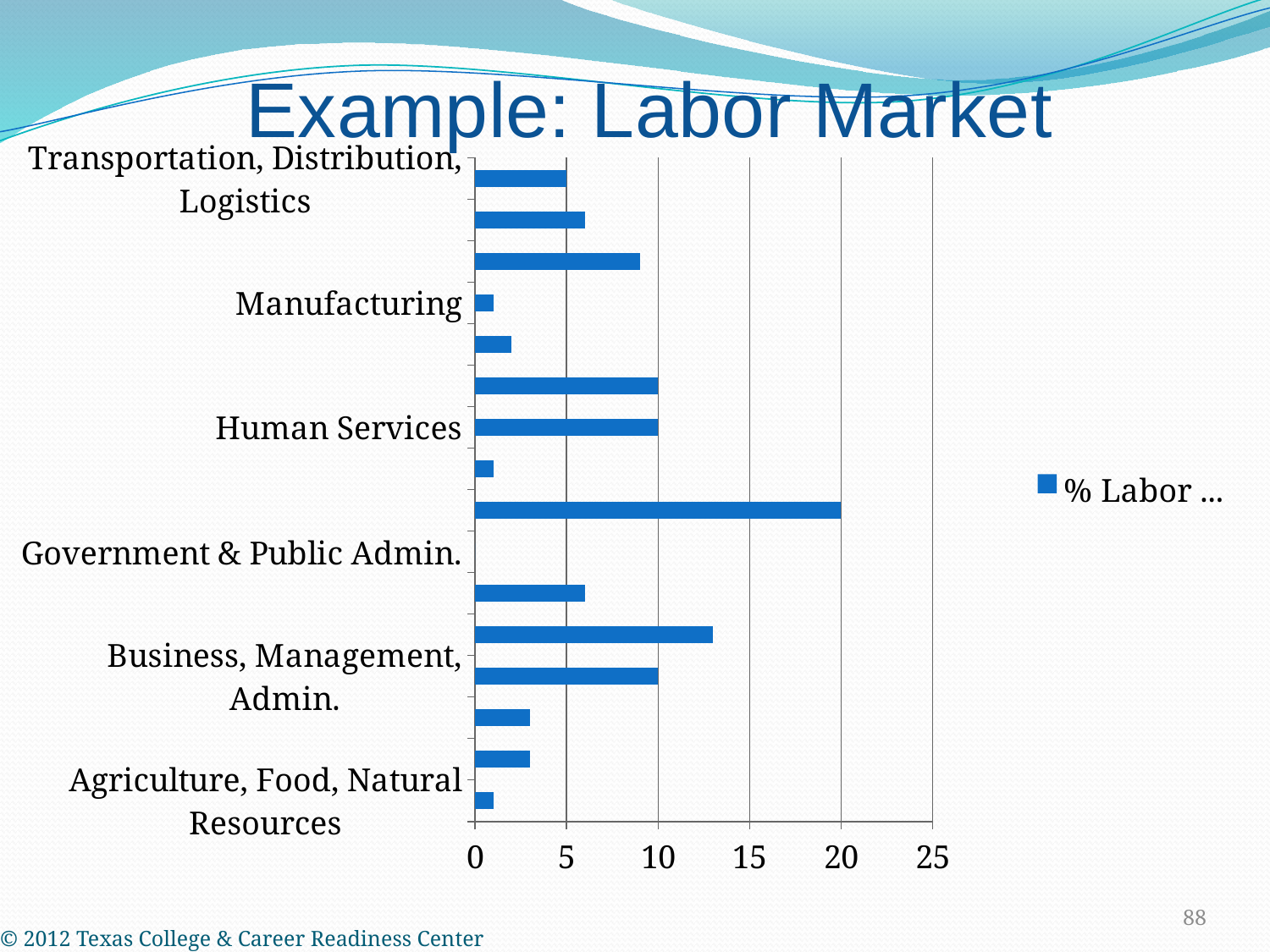
What is the value for Transportation, Distribution, Logistics? 5 What is the highest value shown on the x axis? 25 Which has the larger value, Business, Management, Admin. or Agriculture, Food, Natural Resources? Business, Management, Admin. Is the value for Business, Management, Admin. greater or less than 5? greater Is the value for Manufacturing greater or less than 5? less Is the value for Human Services greater or less than 5? greater How many series does the legend list? 1 Which has the larger value, Human Services or Manufacturing? Human Services What kind of chart is shown on the slide? bar chart What is the value for Human Services? 10 What is the title of the slide containing the chart? Example: Labor Market